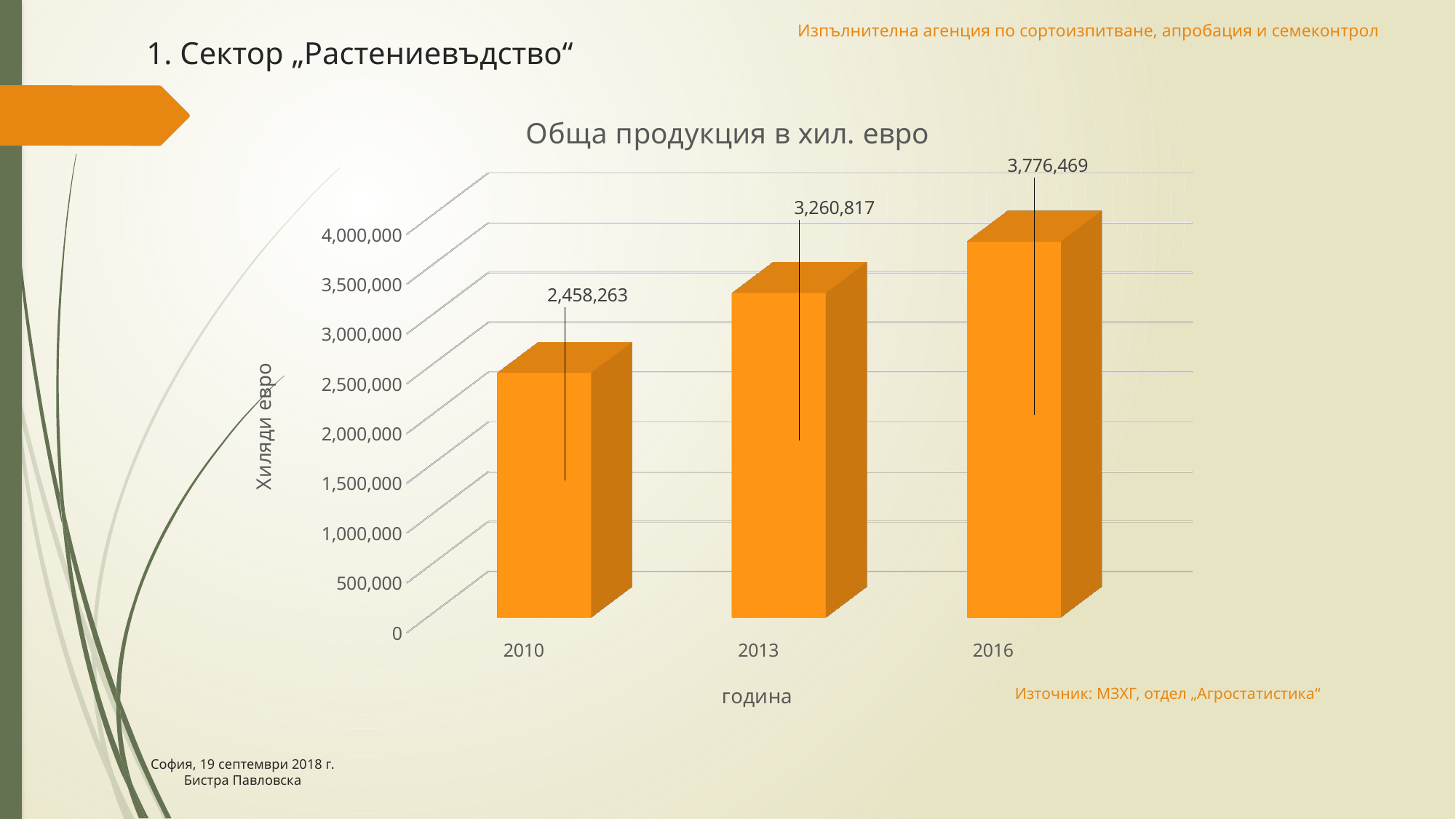
Do the values rise or fall from 2010 to 2016? rise How many years are shown on the x axis? 3 What is the value for 2010? 2,458,263 What is the value for 2013? 3,260,817 What is the difference between the values for 2016 and 2013? 515,652 Which year has the highest value? 2016 Is the value for 2010 greater or less than 3,000,000? less What is the difference between the values for 2013 and 2010? 802,554 Which year has the lowest value? 2010 Which is larger, the value for 2010 or the value for 2013? 2013 What kind of chart is shown? bar chart What is the value for 2016? 3,776,469